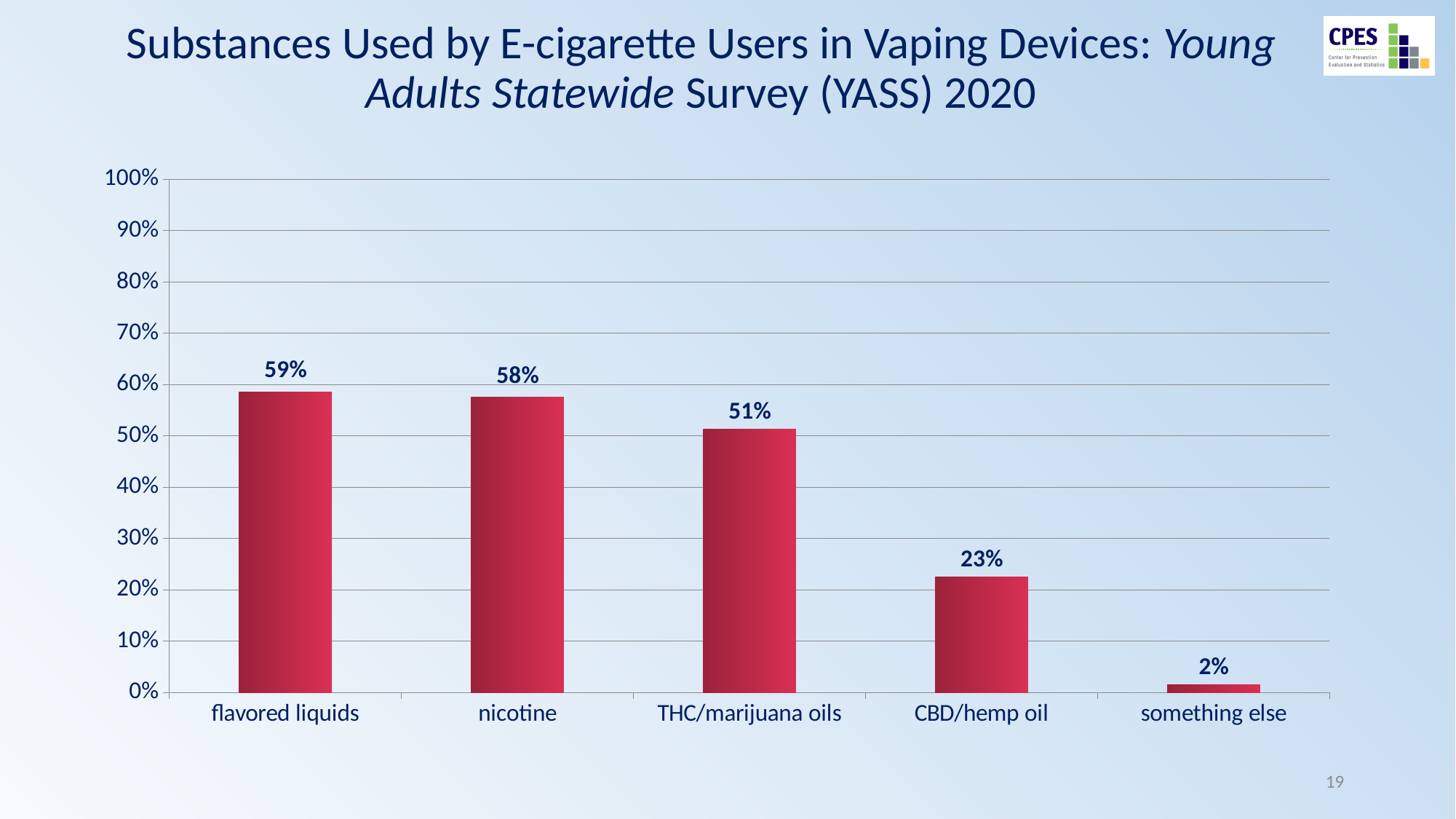
Which is larger, the value for nicotine or the value for CBD/hemp oil? nicotine What percentage is shown for THC/marijuana oils? 51% What is the difference in percentage points between THC/marijuana oils and CBD/hemp oil? 28 How many substance categories are shown in the chart? 5 Which substance has the highest percentage in the chart? flavored liquids What is the value shown for nicotine? 58% What is the value for CBD/hemp oil? 23% What percentage of e-cigarette users reported using flavored liquids in vaping devices? 59% What type of chart is shown on the slide? bar chart What percentage is shown for 'something else'? 2% Which substance has the lowest percentage in the chart? something else Do the values rise or fall moving from left to right across the categories? fall